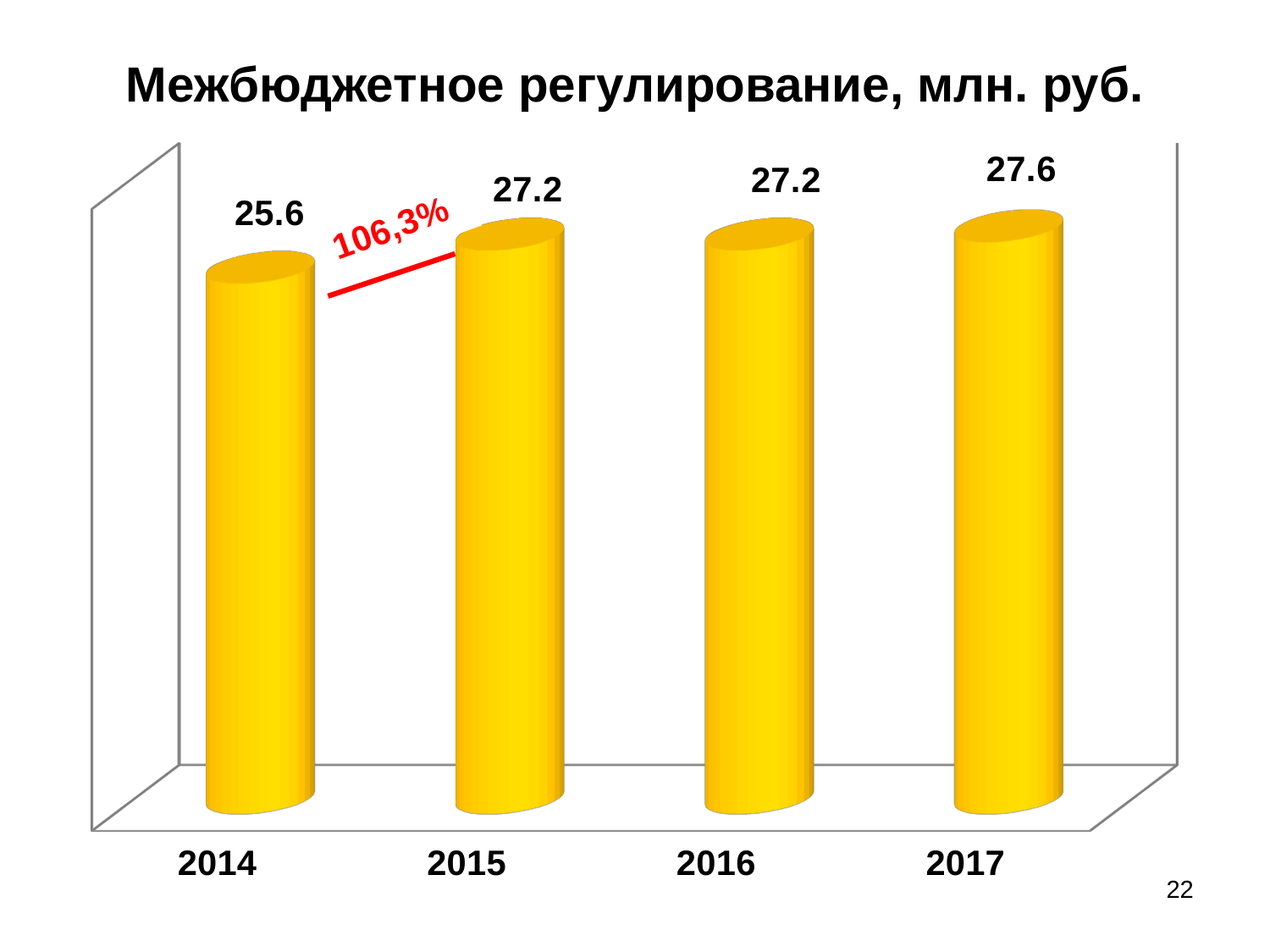
What is the difference between the values for 2015 and 2014? 1.6 Which year has the highest value? 2017 What is the value for 2015? 27.2 What kind of chart is this? bar chart Do the values generally rise or fall from 2014 to 2017? rise Which is larger, the value for 2014 or the value for 2017? 2017 What is the value for 2017? 27.6 What percentage is written in red between the 2014 and 2015 bars? 106,3% How many years are shown on the chart? 4 Which year has the lowest value? 2014 What is the value for 2014? 25.6 What is the difference between the values for 2017 and 2016? 0.4